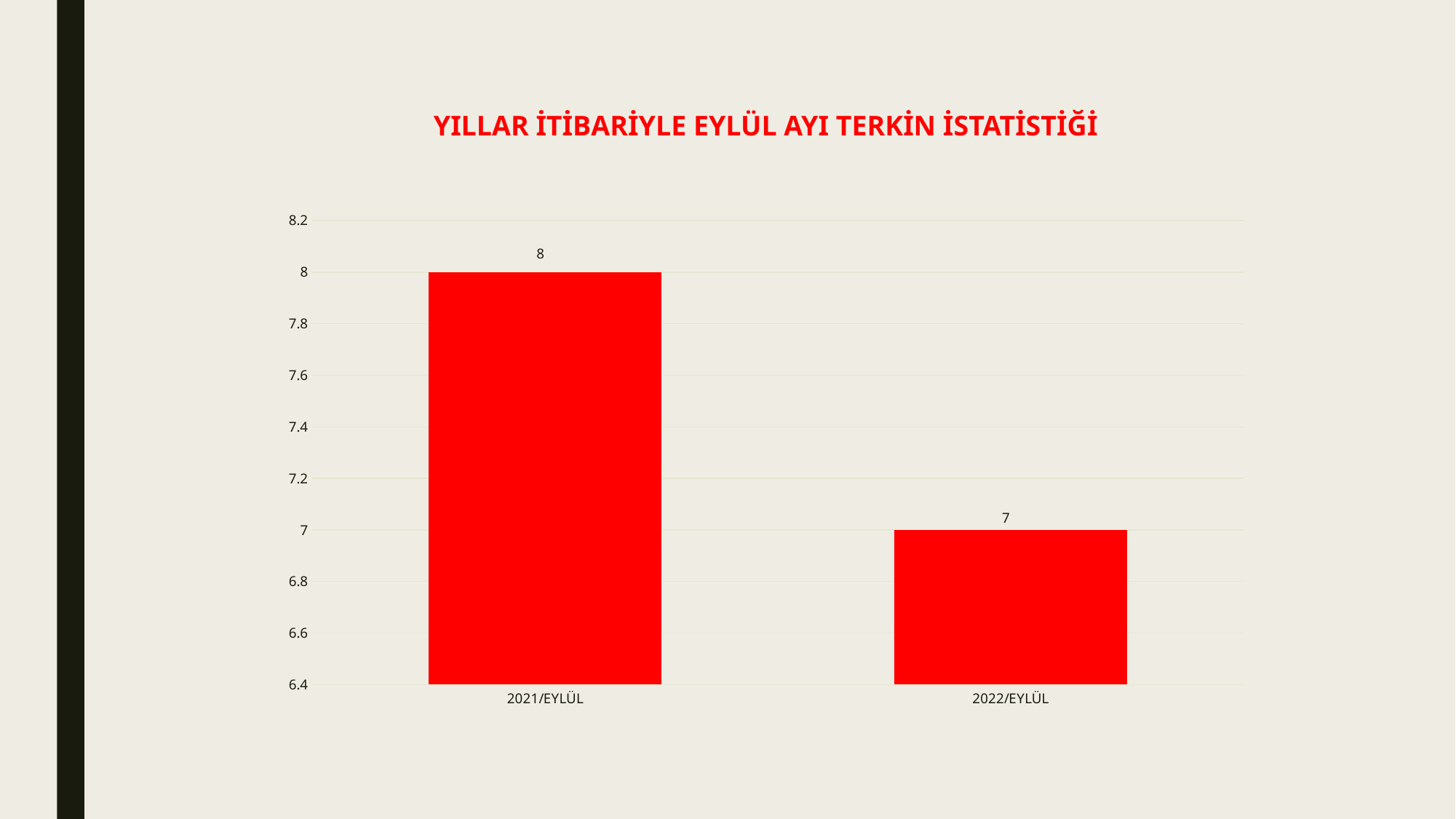
Is the value for 2022/EYLÜL greater or less than 7.4? less Which category has the highest value? 2021/EYLÜL Which category has the lowest value? 2022/EYLÜL Do the values rise or fall from 2021/EYLÜL to 2022/EYLÜL? fall How many categories are shown on the x axis? 2 What is the value for 2021/EYLÜL? 8 Which is larger, the value for 2021/EYLÜL or the value for 2022/EYLÜL? 2021/EYLÜL What is the difference between the values for 2021/EYLÜL and 2022/EYLÜL? 1 What is the value for 2022/EYLÜL? 7 What kind of chart is shown on the slide? bar chart What is the title of the chart? YILLAR İTİBARİYLE EYLÜL AYI TERKİN İSTATİSTİĞİ Is the value for 2021/EYLÜL greater or less than 7.6? greater